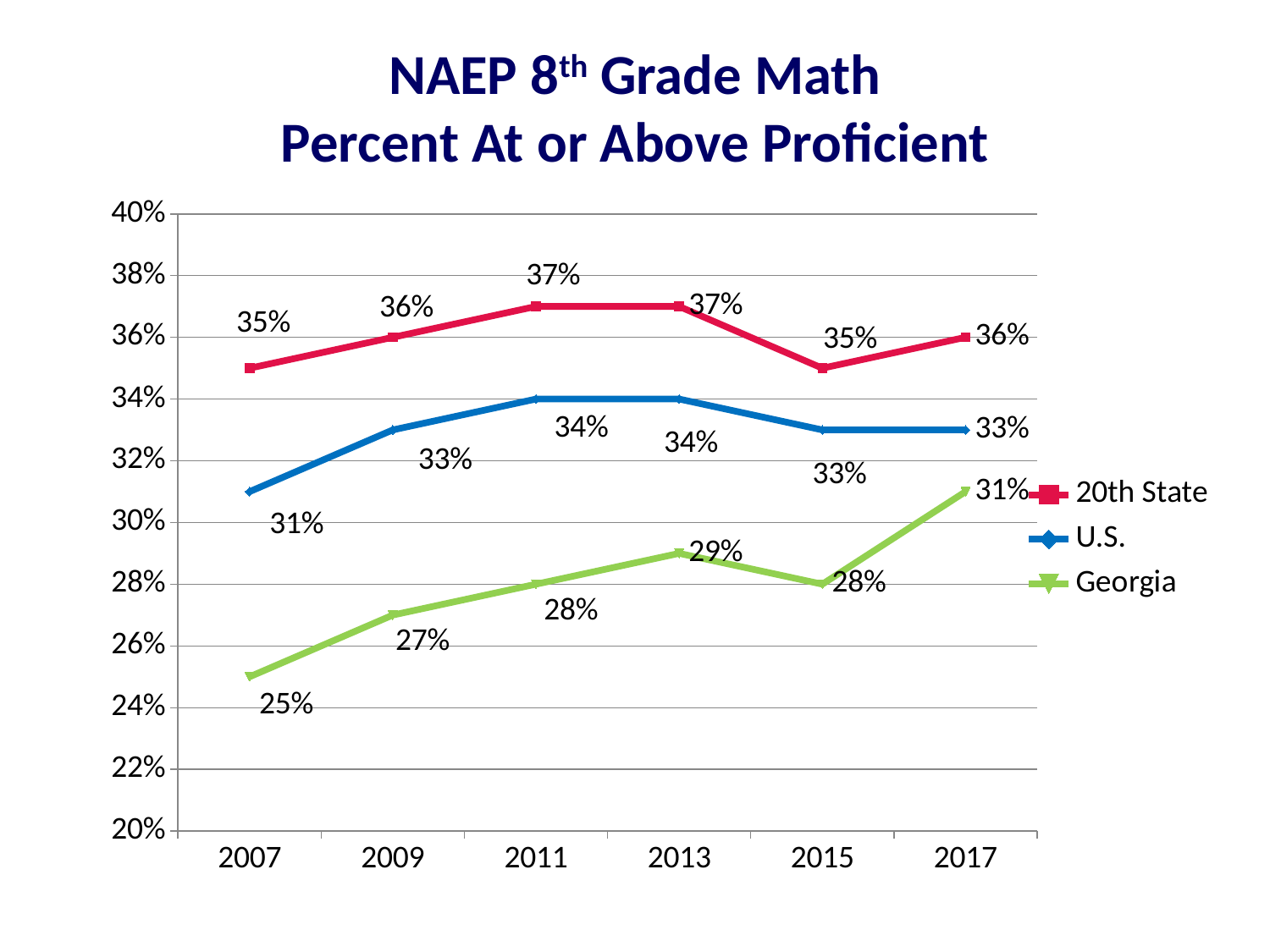
What is the difference between the 20th State value and the Georgia value in 2017? 5% In which year is the Georgia value highest? 2017 What is the value for U.S. in 2015? 33% How many years are shown on the x axis? 6 Does the Georgia value rise or fall from 2007 to 2013? rise What is the value for the 20th State series in 2011? 37% How many series does the legend list? 3 Is the Georgia value in 2009 greater or less than 30%? less What kind of chart is this? line chart Which is larger in 2013: the U.S. value or the Georgia value? U.S. What is the value for Georgia in 2007? 25% In which year is the U.S. value lowest? 2007